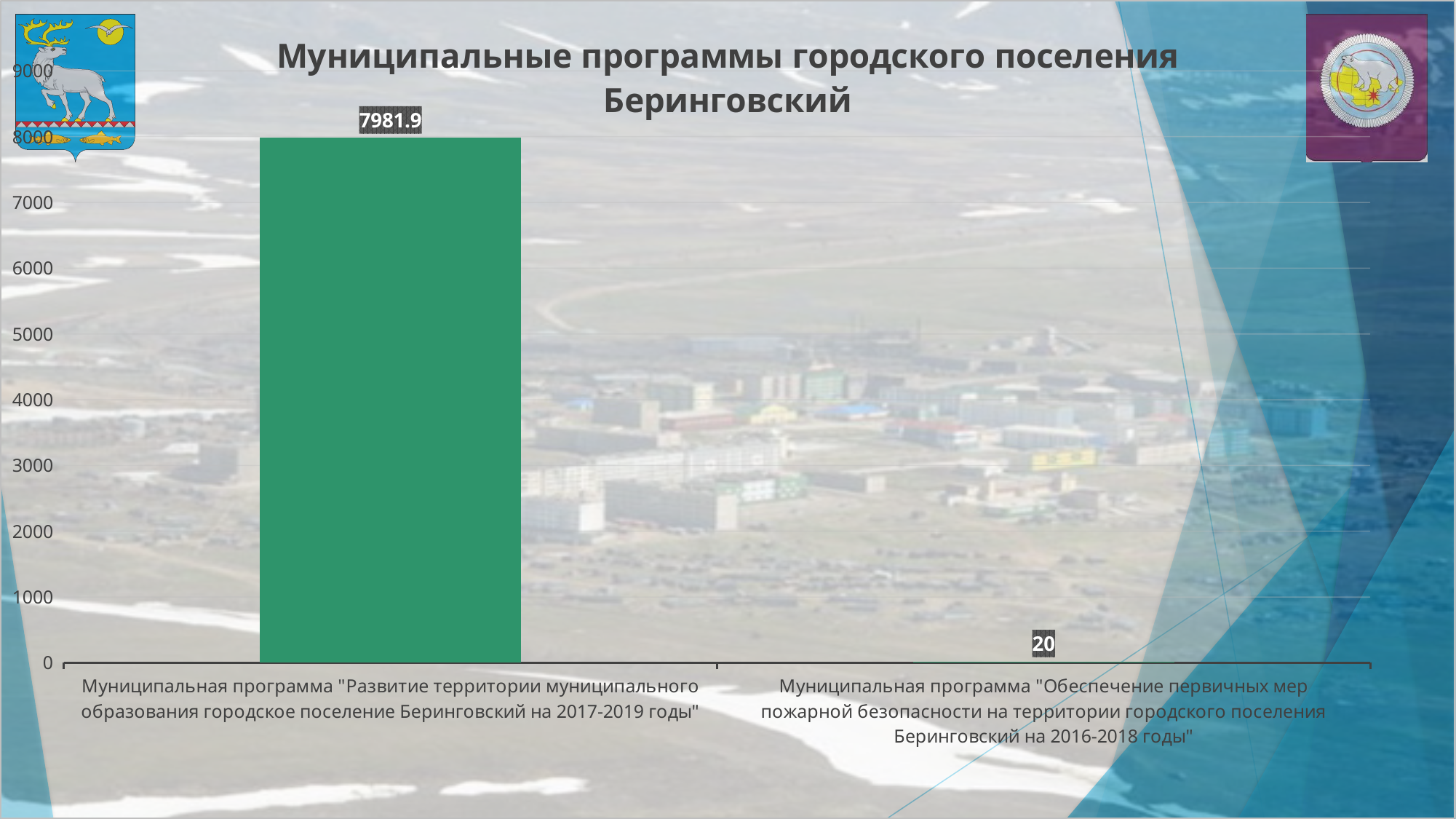
Which program has the lowest value on the chart? Муниципальная программа "Обеспечение первичных мер пожарной безопасности на территории городского поселения Беринговский на 2016-2018 годы" What is the title of the chart? Муниципальные программы городского поселения Беринговский Is the value for the territory development program greater or less than 7000? greater What is the value for the program "Обеспечение первичных мер пожарной безопасности на территории городского поселения Беринговский на 2016-2018 годы"? 20 Which is larger: the value for the territory development program or the value for the fire safety program? The territory development program What kind of chart is shown on the slide? Bar chart What is the value for the program "Развитие территории муниципального образования городское поселение Беринговский на 2017-2019 годы"? 7981.9 Which program has the highest value on the chart? Муниципальная программа "Развитие территории муниципального образования городское поселение Беринговский на 2017-2019 годы" Is the value for the fire safety program greater or less than 1000? less What is the difference between the value for the territory development program (7981.9) and the fire safety program (20)? 7961.9 How many categories (programs) are shown on the chart? 2 What is the highest value shown on the vertical axis? 9000